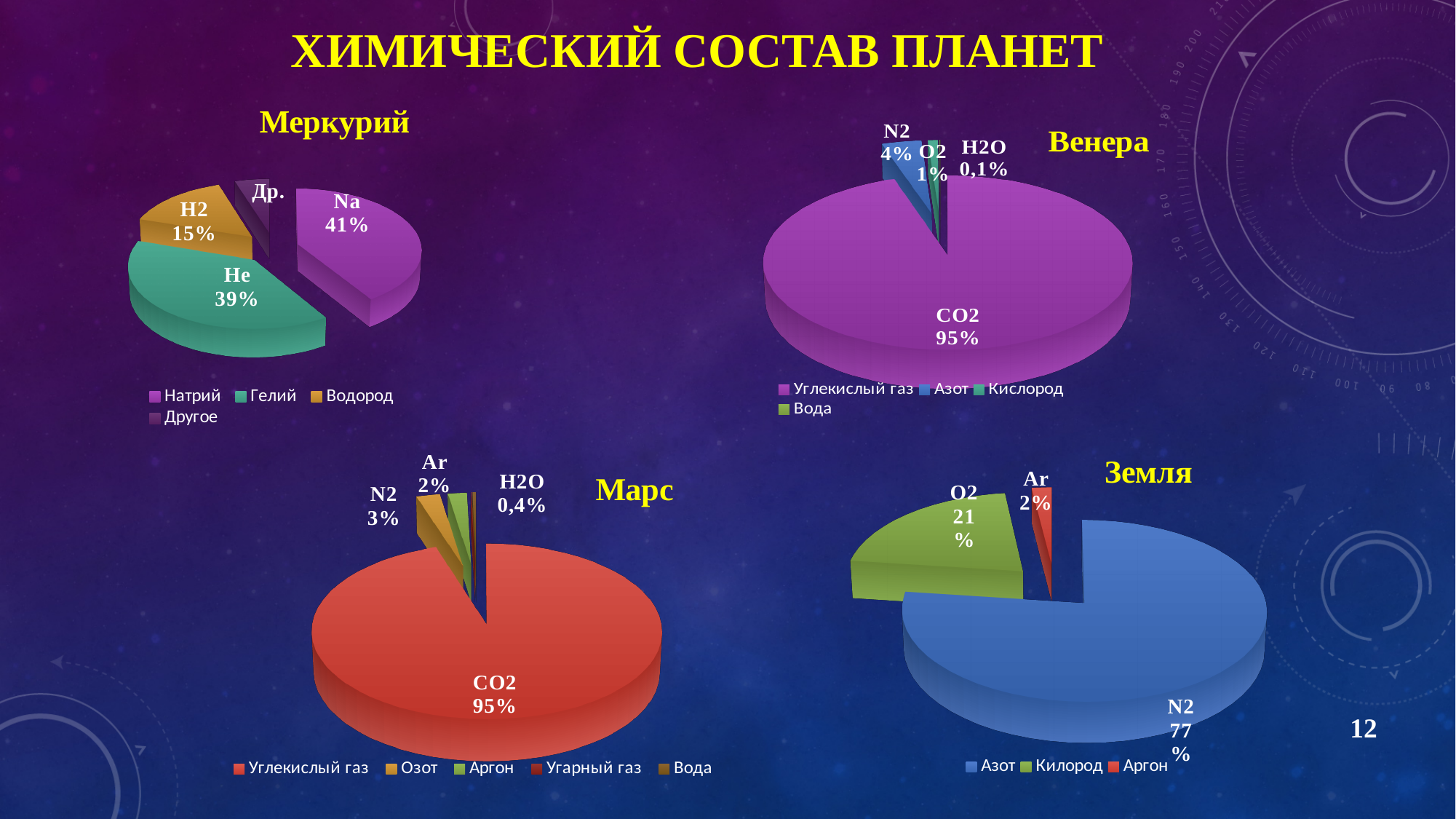
In the Меркурий chart, what is the value for He? 39% In the Венера chart, what is the value for CO2? 95% In the Земля chart, what is the value for O2? 21% How many entries does the legend of the Марс chart list? 5 In the Марс chart, which is larger, N2 or Ar? N2 In the Меркурий chart, what is the difference between the Na and H2 values? 26% In the Меркурий chart, what is the value for Na? 41% In the Венера chart, which labelled slice has the smallest value? H2O In the Марс chart, what is the value for H2O? 0,4% In the Марс chart, which slice is the largest? CO2 In the Венера chart, what is the value for N2? 4% In the Земля chart, what is the difference between the N2 and O2 values? 56%